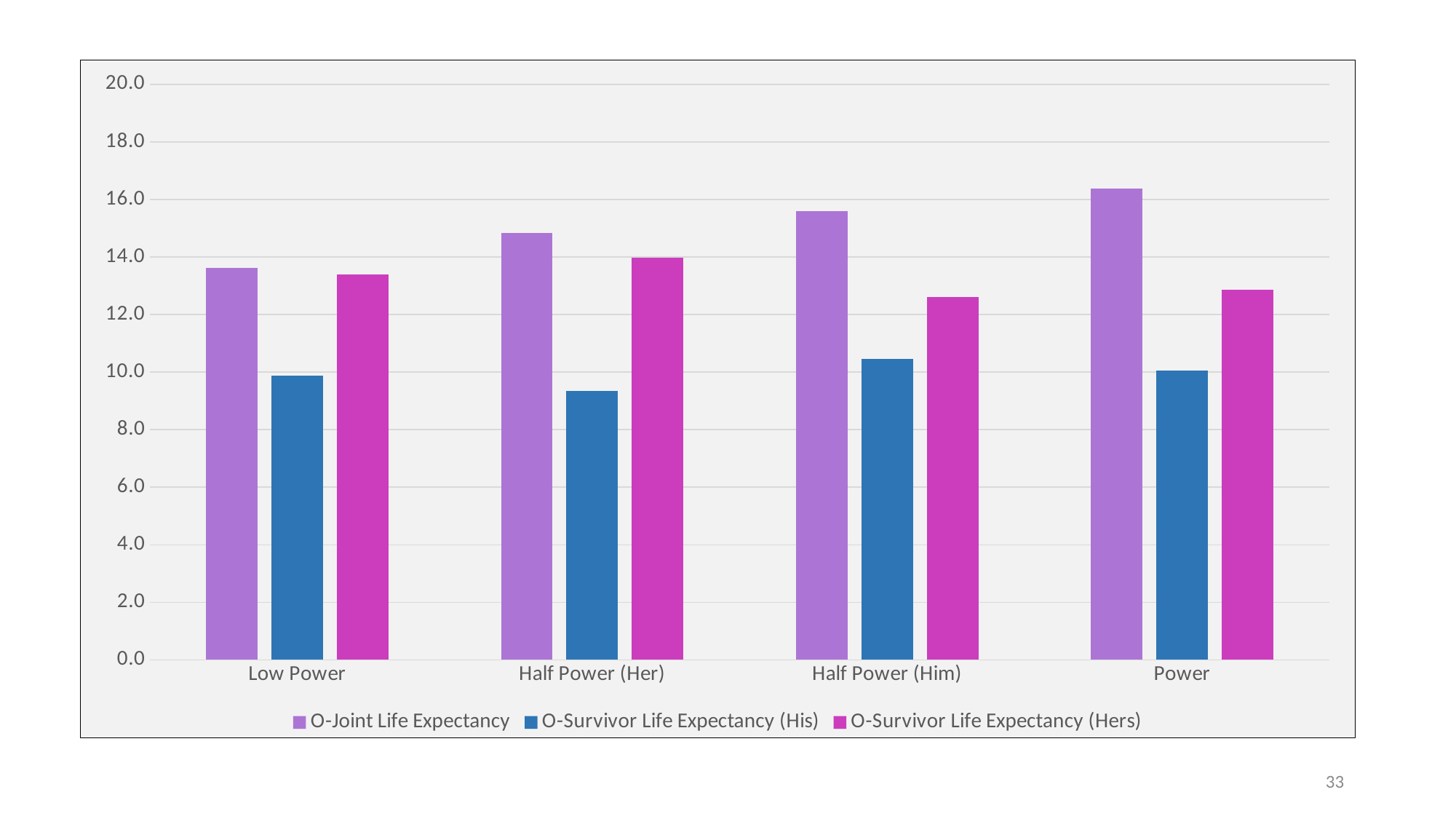
For Half Power (Him), which is larger: O-Survivor Life Expectancy (His) or O-Survivor Life Expectancy (Hers)? O-Survivor Life Expectancy (Hers) Which category has the lowest O-Joint Life Expectancy? Low Power Which category has the lowest O-Survivor Life Expectancy (His)? Half Power (Her) Is the O-Survivor Life Expectancy (His) for Half Power (Her) greater or less than 10.0? less Does the O-Joint Life Expectancy rise or fall from Low Power to Power along the x axis? rise How many series does the legend list? 3 Which category has the highest O-Survivor Life Expectancy (Hers)? Half Power (Her) Is the O-Joint Life Expectancy for Low Power greater or less than 14.0? less What kind of chart is shown on the slide? bar chart Which category has the highest O-Joint Life Expectancy? Power Is the O-Joint Life Expectancy for Power greater or less than 16.0? greater How many categories are shown on the x axis? 4